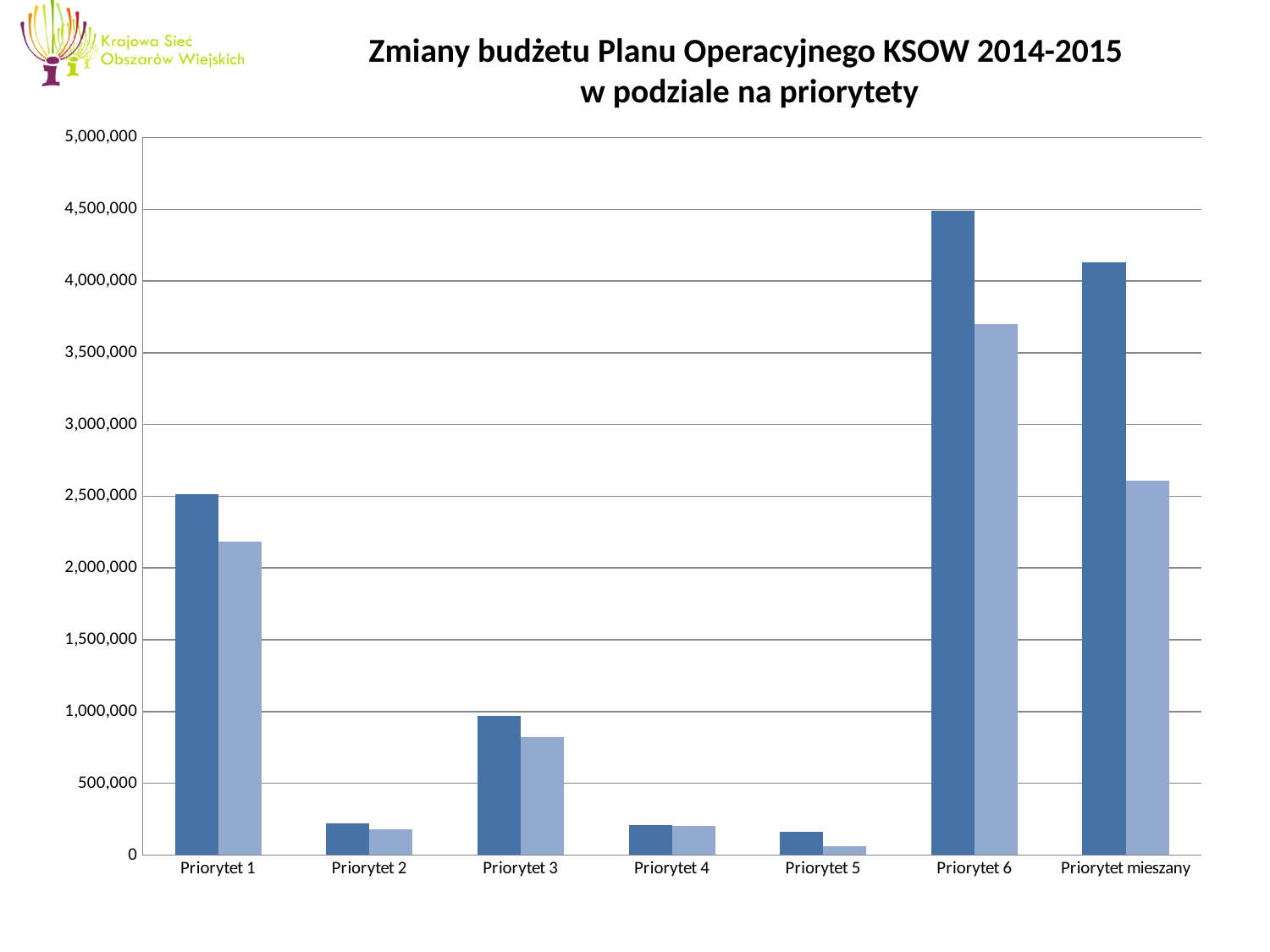
Which category has the tallest dark blue bar? Priorytet 6 Which is larger: the dark blue bar for Priorytet 6 or the dark blue bar for Priorytet mieszany? Priorytet 6 What is the title of the chart? Zmiany budżetu Planu Operacyjnego KSOW 2014-2015 w podziale na priorytety What kind of chart is shown on the slide? bar chart Is the light blue bar for Priorytet 1 greater or less than 2,000,000? greater How many bars are plotted for each category in the chart? 2 How many categories are shown on the x axis of the chart? 7 Which category has the shortest dark blue bar? Priorytet 5 Is the dark blue bar for Priorytet 6 greater or less than 4,000,000? greater Which category has the shortest light blue bar? Priorytet 5 Is the dark blue bar for Priorytet 2 greater or less than 500,000? less